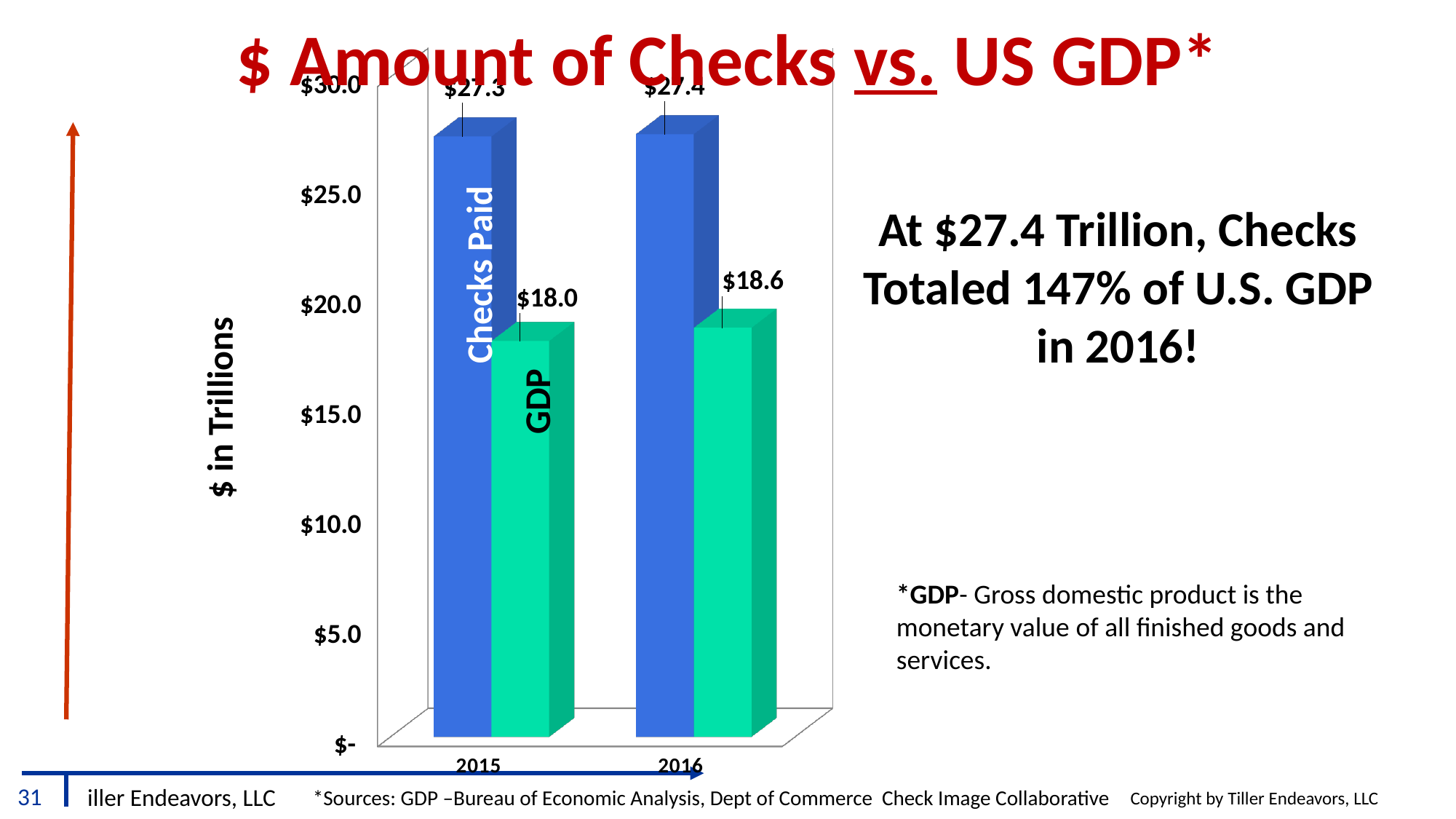
What is the difference between Checks Paid and GDP in 2015? $9.3 How many data series does the chart show? 2 What is the value of GDP in 2016? $18.6 What is the value of Checks Paid in 2015? $27.3 What kind of chart is shown on the slide? Bar chart What is the value of Checks Paid in 2016? $27.4 Which year has the higher GDP value? 2016 Which is larger in 2015, Checks Paid or GDP? Checks Paid What is the value of GDP in 2015? $18.0 What is the label of the vertical axis? $ in Trillions What is the difference between Checks Paid and GDP in 2016? $8.8 How many years are shown on the x axis? 2